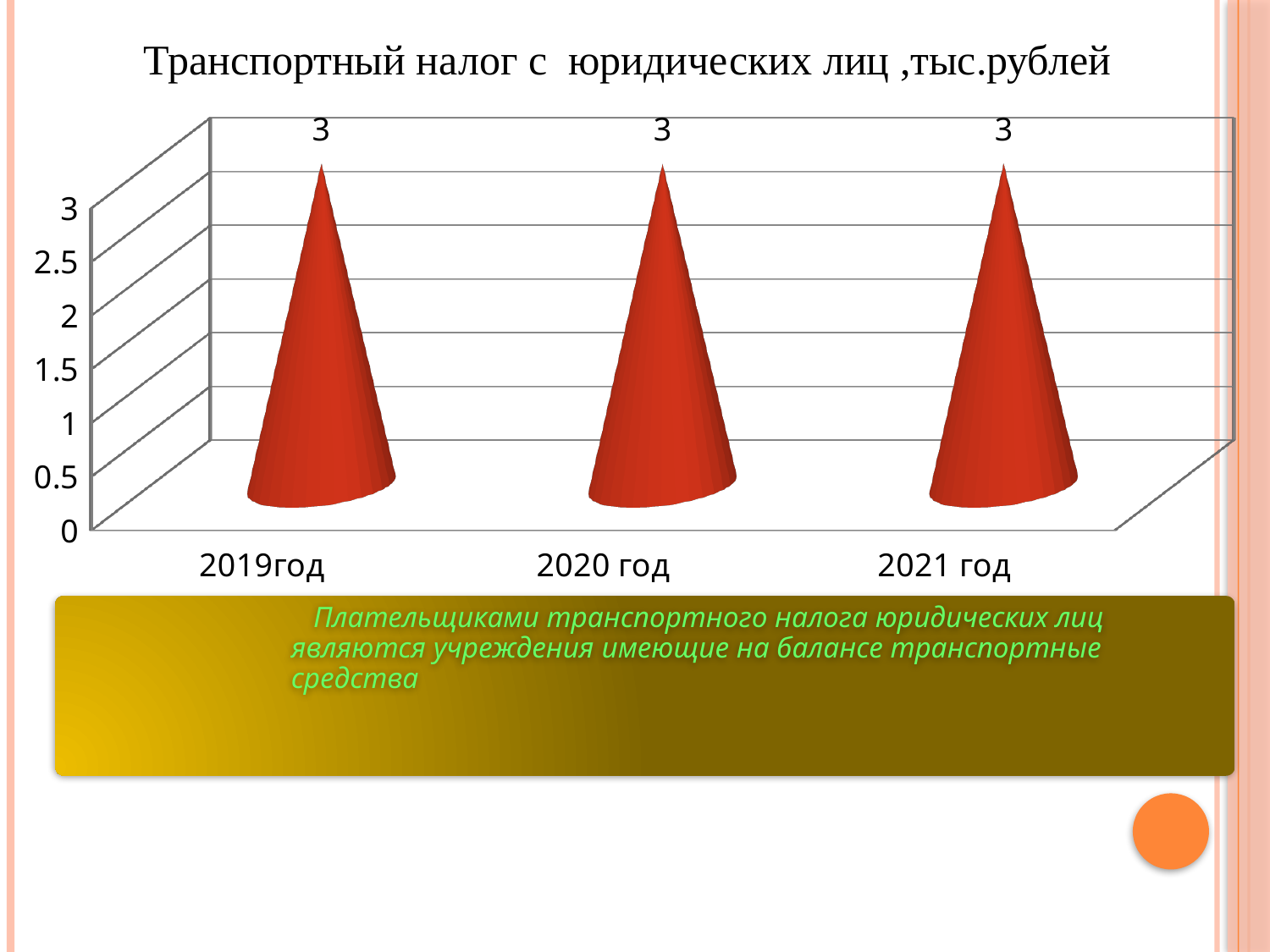
What is the value for 2020 год? 3 Do the values rise, fall or stay the same from 2019год to 2021 год? Stay the same What is the difference between the values for 2021 год and 2019год? 0 What kind of chart is shown on the slide? Bar chart Is the value for 2021 год greater or less than 2? greater How many categories are shown on the x axis? 3 What colour are the bars in the chart? Red What is the title of the chart? Транспортный налог с юридических лиц ,тыс.рублей What is the value for 2019год? 3 What is the value for 2021 год? 3 Is the value for 2020 год larger than, smaller than or equal to the value for 2019год? Equal What is the highest tick value shown on the vertical axis? 3